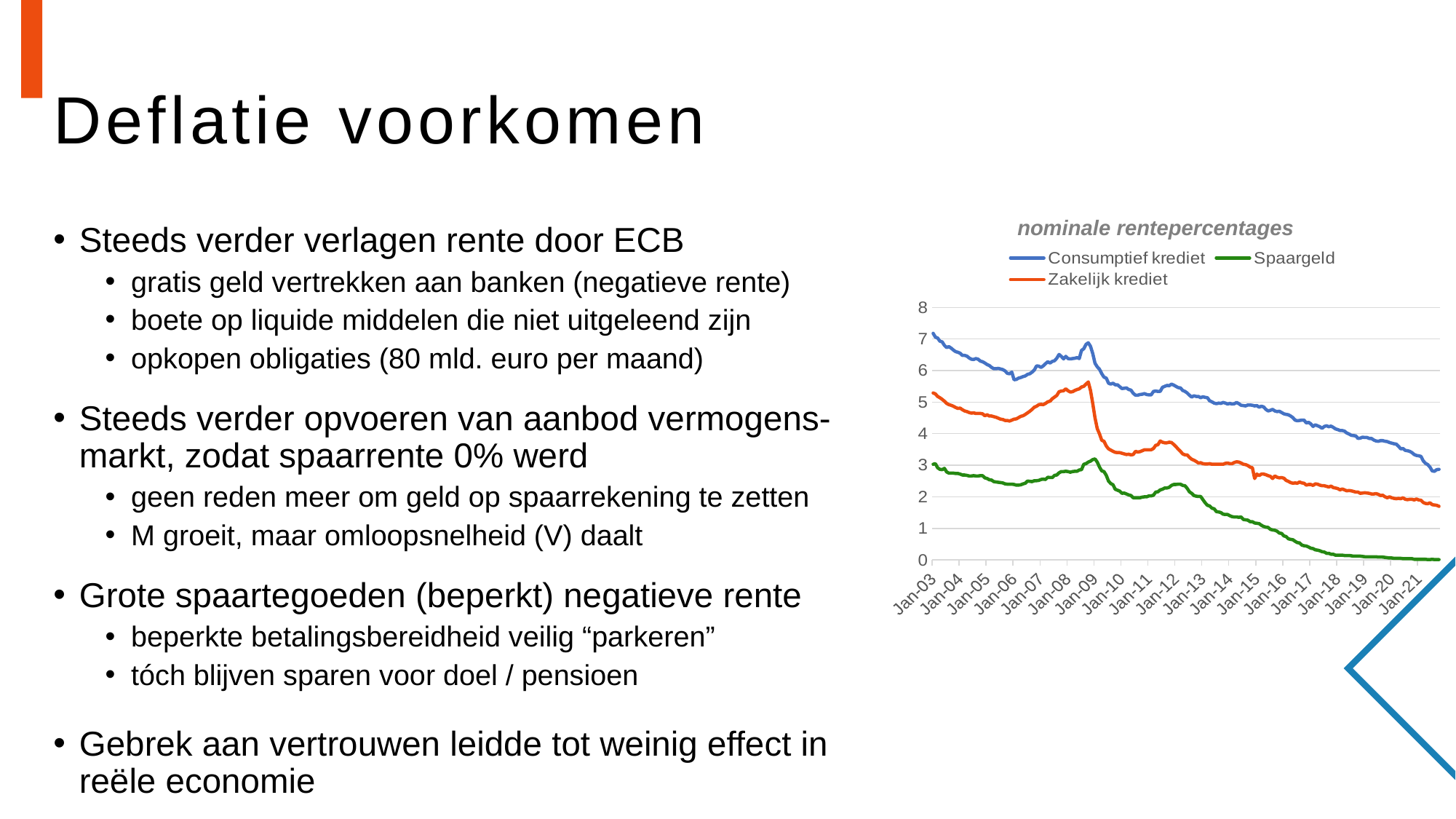
Is the value for Consumptief krediet at Jan-03 greater or less than 6? greater What kind of chart is shown on the slide? line chart How many year labels are shown on the x axis of the chart? 19 Does the Consumptief krediet line rise or fall overall from Jan-03 to Jan-21? fall What is the title of the chart? nominale rentepercentages Is the value for Zakelijk krediet at Jan-03 greater or less than 4? greater Does the Spaargeld line rise or fall overall from Jan-03 to Jan-21? fall How many series does the legend of the chart list? 3 Which series has the highest value at Jan-21? Consumptief krediet At Jan-03, which is higher: Consumptief krediet or Spaargeld? Consumptief krediet What colour is the Spaargeld line in the chart? green Is the value for Spaargeld at Jan-21 greater or less than 1? less